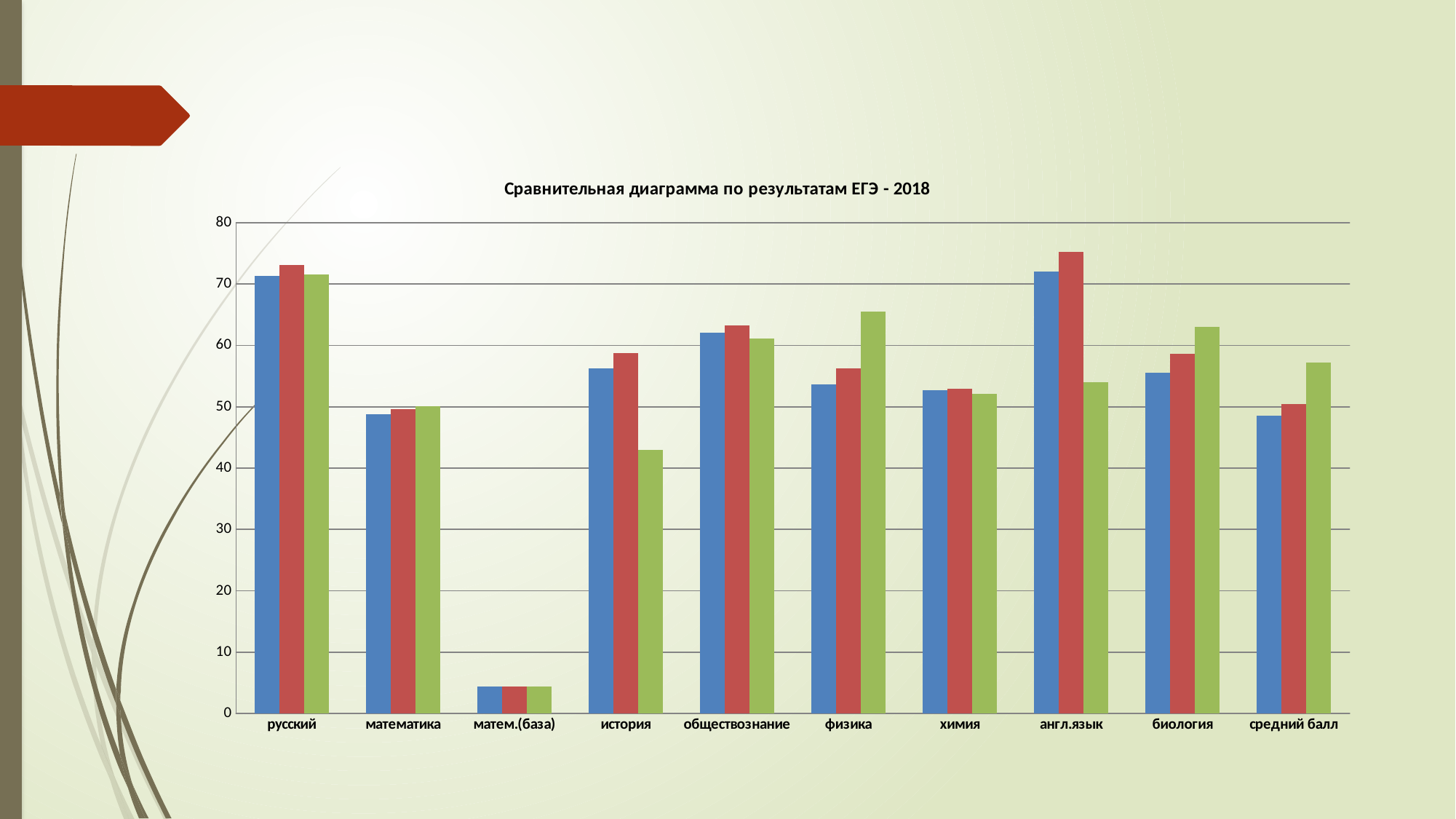
Are the bars for матем.(база) greater or less than 10? less For англ.язык, which is larger: the red bar or the green bar? the red bar Is the value of the green bar for физика greater or less than 60? greater How many categories are shown on the x axis of the chart? 10 Which category has the lowest bars in the chart? матем.(база) Is the value of the green bar for история greater or less than 50? less How many bars are plotted for each category in the chart? 3 For физика, which is larger: the blue bar or the green bar? the green bar What kind of chart is shown on the slide? bar chart For история, which is larger: the red bar or the green bar? the red bar What is the title of the chart? Сравнительная диаграмма по результатам ЕГЭ - 2018